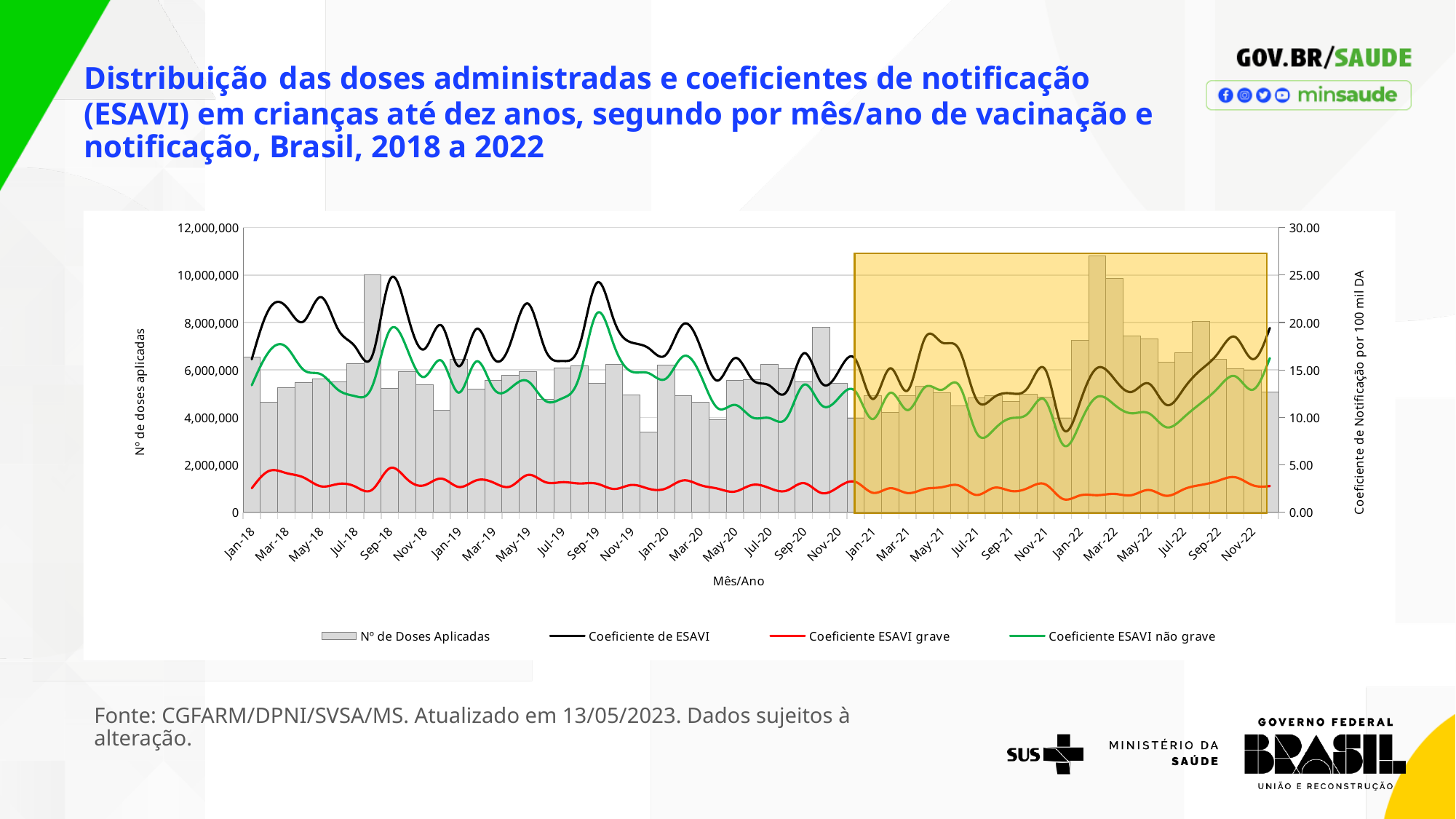
Which of the three coefficient lines stays lowest across the whole period? Coeficiente ESAVI grave Is the Nº de Doses Aplicadas bar for Feb-22 greater or less than 10,000,000? greater How many series does the chart legend list? 4 Which is larger, the Nº de Doses Aplicadas bar for Feb-22 or for Aug-18? Feb-22 In which month is the bar for Nº de Doses Aplicadas the lowest? Dec-19 What kind of chart is shown on the slide? Combined bar and line chart Is the Nº de Doses Aplicadas bar for Dec-19 greater or less than 4,000,000? less Is the Coeficiente ESAVI grave value for Jan-22 greater or less than 5.00? less What is the title of the right-hand vertical axis? Coeficiente de Notificação por 100 mil DA In which month is the bar for Nº de Doses Aplicadas the highest? Feb-22 Which series is plotted as bars? Nº de Doses Aplicadas